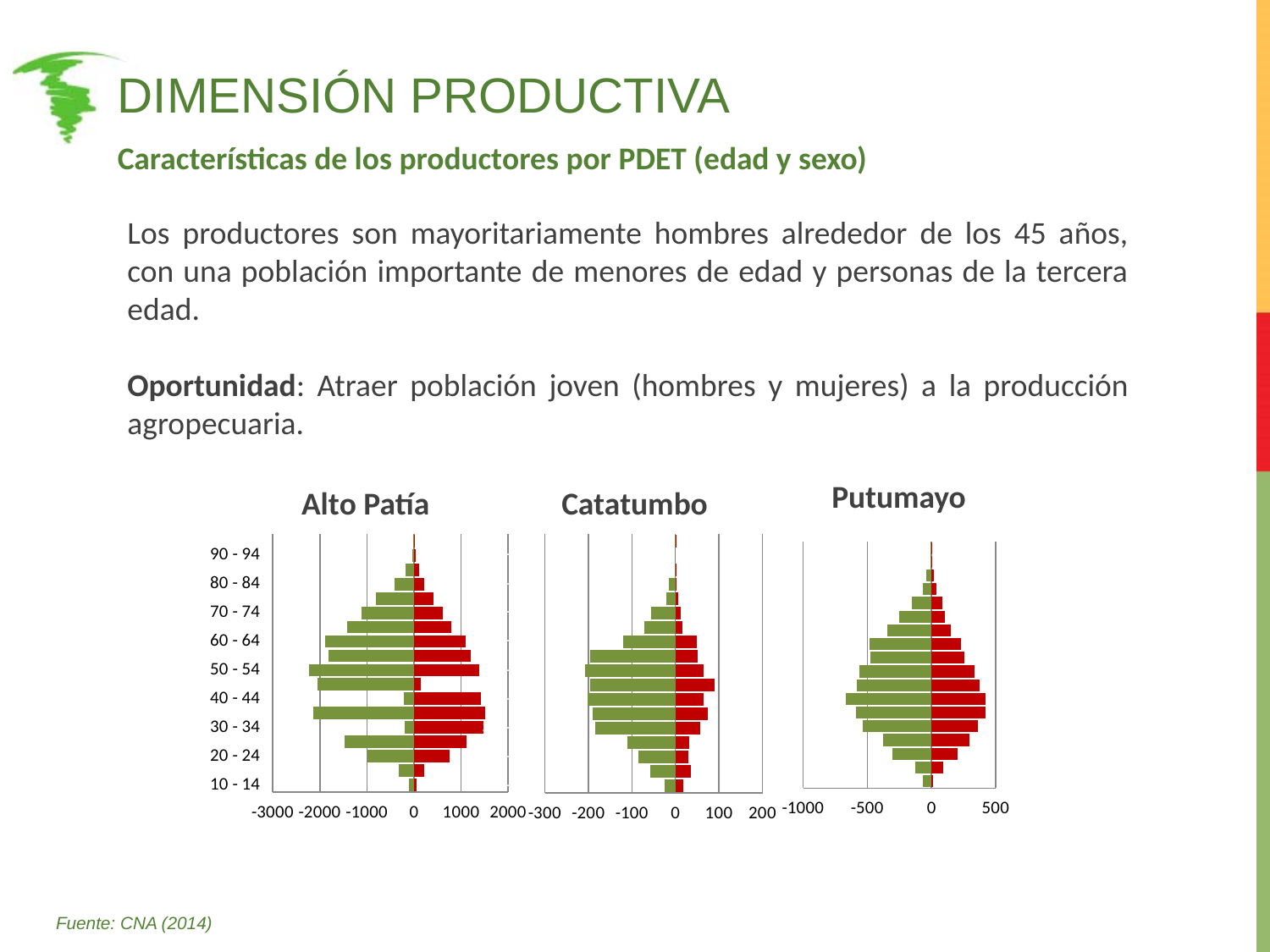
In the Alto Patía chart, which red bar is longer: 50 - 54 or 20 - 24? 50 - 54 What is the source cited for the charts on the slide? CNA (2014) In the Alto Patía chart, which age group has the longest green bar? 50 - 54 In the Putumayo chart, is the value of the green bar for 40 - 44 greater or less than -500? less In the Alto Patía chart, is the value of the green bar for 50 - 54 greater or less than -2000? less In the Alto Patía chart, is the value of the red bar for 50 - 54 greater or less than 1000? greater What kind of chart is the Alto Patía chart? Bar chart What are the titles of the three charts on the slide, from left to right? Alto Patía, Catatumbo, Putumayo In the Putumayo chart, which age group has the longest green bar? 40 - 44